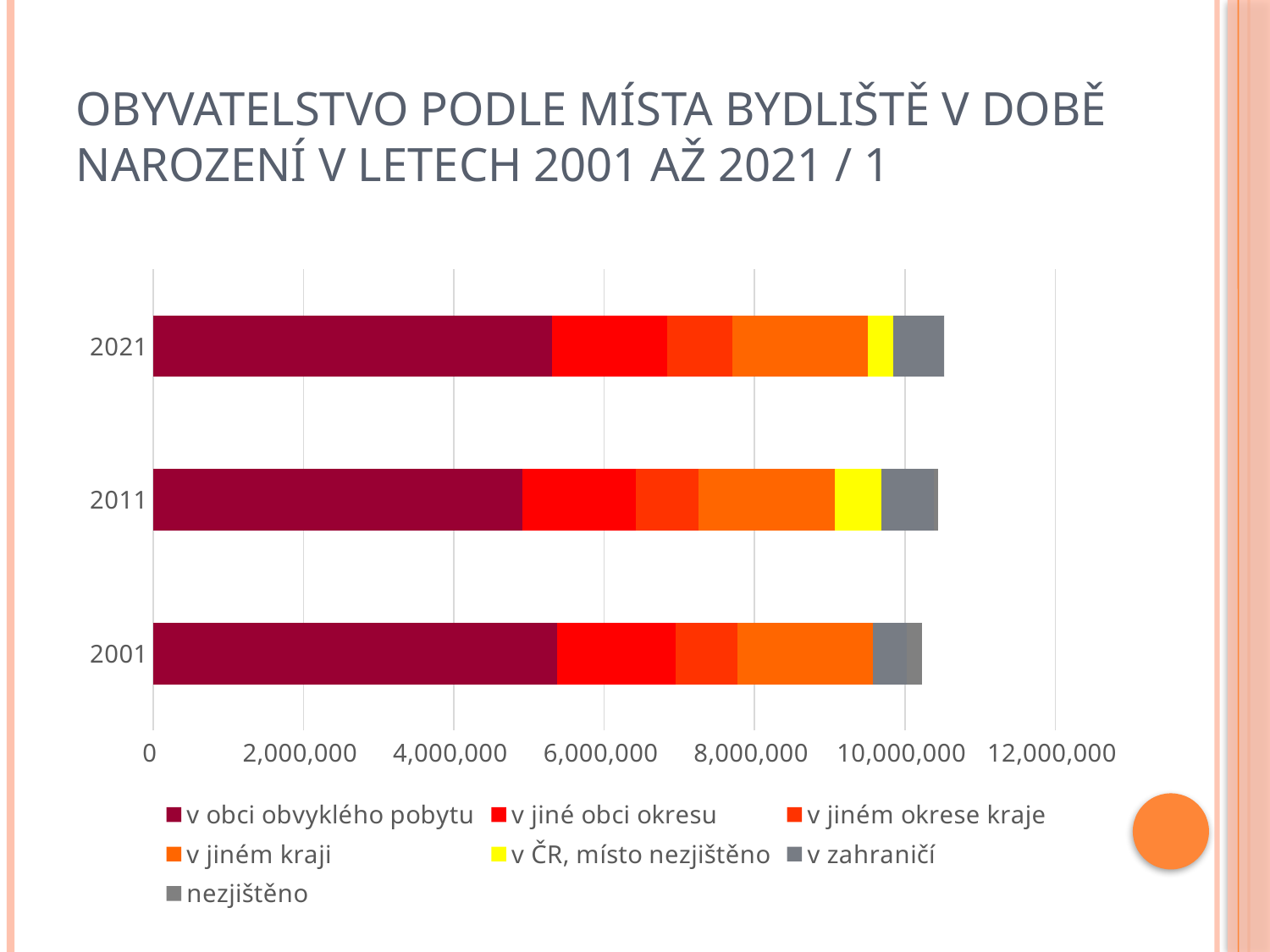
Is the value of 'v obci obvyklého pobytu' for 2001 greater or less than 4,000,000? greater Which year has the smallest 'v obci obvyklého pobytu' segment? 2011 How many years (categories) are plotted on the chart? 3 What kind of chart is shown on the slide? stacked bar chart How many series does the legend list? 7 Which colour represents 'v ČR, místo nezjištěno' in the legend? yellow What is the highest value shown on the horizontal axis? 12,000,000 Is the total length of the 2001 bar greater or less than 12,000,000? less Is the total length of the 2021 bar greater or less than 10,000,000? greater Which year has the largest 'v ČR, místo nezjištěno' (yellow) segment? 2011